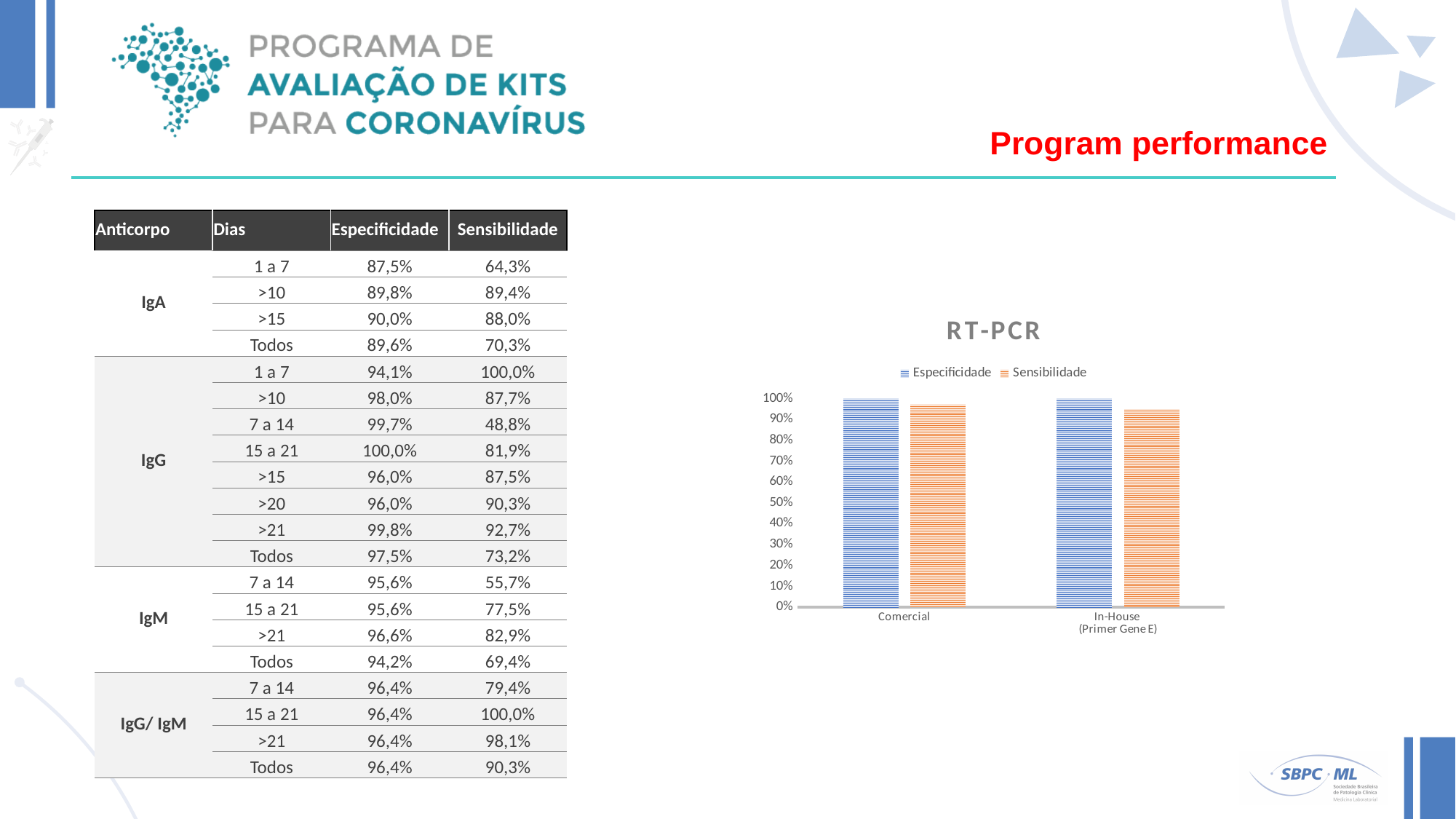
What is the title of the chart on the slide? RT-PCR In the RT-PCR chart, is the Sensibilidade value for In-House (Primer Gene E) greater or less than 90%? greater What kind of chart is shown on the slide? bar chart How many categories are shown on the x axis of the RT-PCR chart? 2 In the RT-PCR chart, which is larger for In-House (Primer Gene E): Especificidade or Sensibilidade? Especificidade In the RT-PCR chart, is the Sensibilidade value for Comercial greater or less than 90%? greater In the RT-PCR chart, is the Sensibilidade value for In-House (Primer Gene E) greater or less than 100%? less In the RT-PCR chart, which category has the lowest Sensibilidade bar? In-House (Primer Gene E) How many series does the chart's legend list? 2 Which series in the RT-PCR chart is drawn in orange? Sensibilidade In the RT-PCR chart, which is larger for Comercial: Especificidade or Sensibilidade? Especificidade